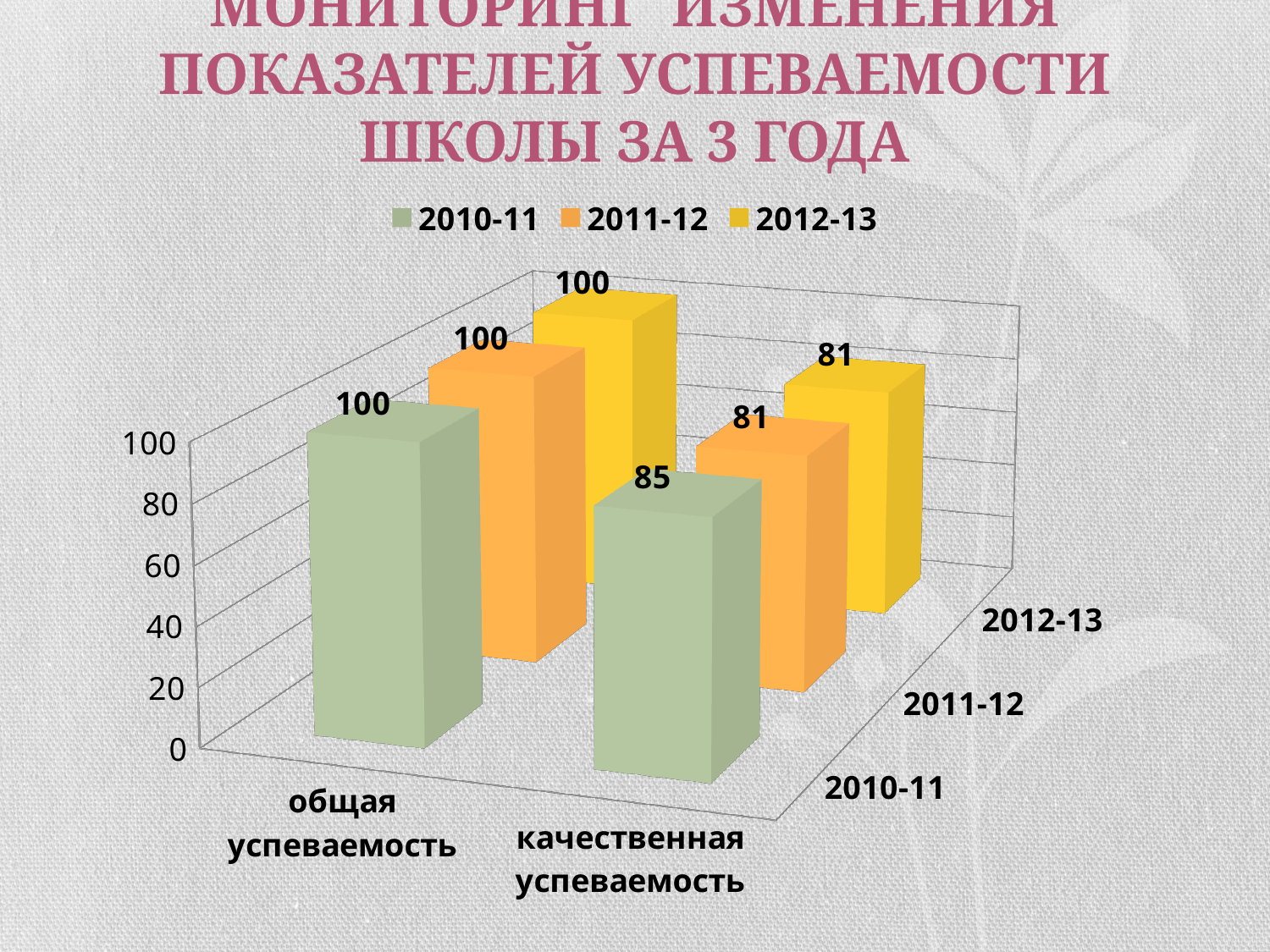
What is the difference between качественная успеваемость in 2010-11 and in 2011-12? 4 What kind of chart is shown on the slide? bar chart Which year has the highest value for качественная успеваемость? 2010-11 Which is larger: качественная успеваемость in 2010-11 or in 2012-13? 2010-11 Which series is shown in yellow in the legend? 2012-13 What is the difference between общая успеваемость and качественная успеваемость in 2012-13? 19 What is the value for общая успеваемость in 2010-11? 100 What is the value for общая успеваемость in 2011-12? 100 What is the value for качественная успеваемость in 2010-11? 85 How many series does the legend list? 3 What is the value for качественная успеваемость in 2012-13? 81 How many categories are shown on the x axis? 2